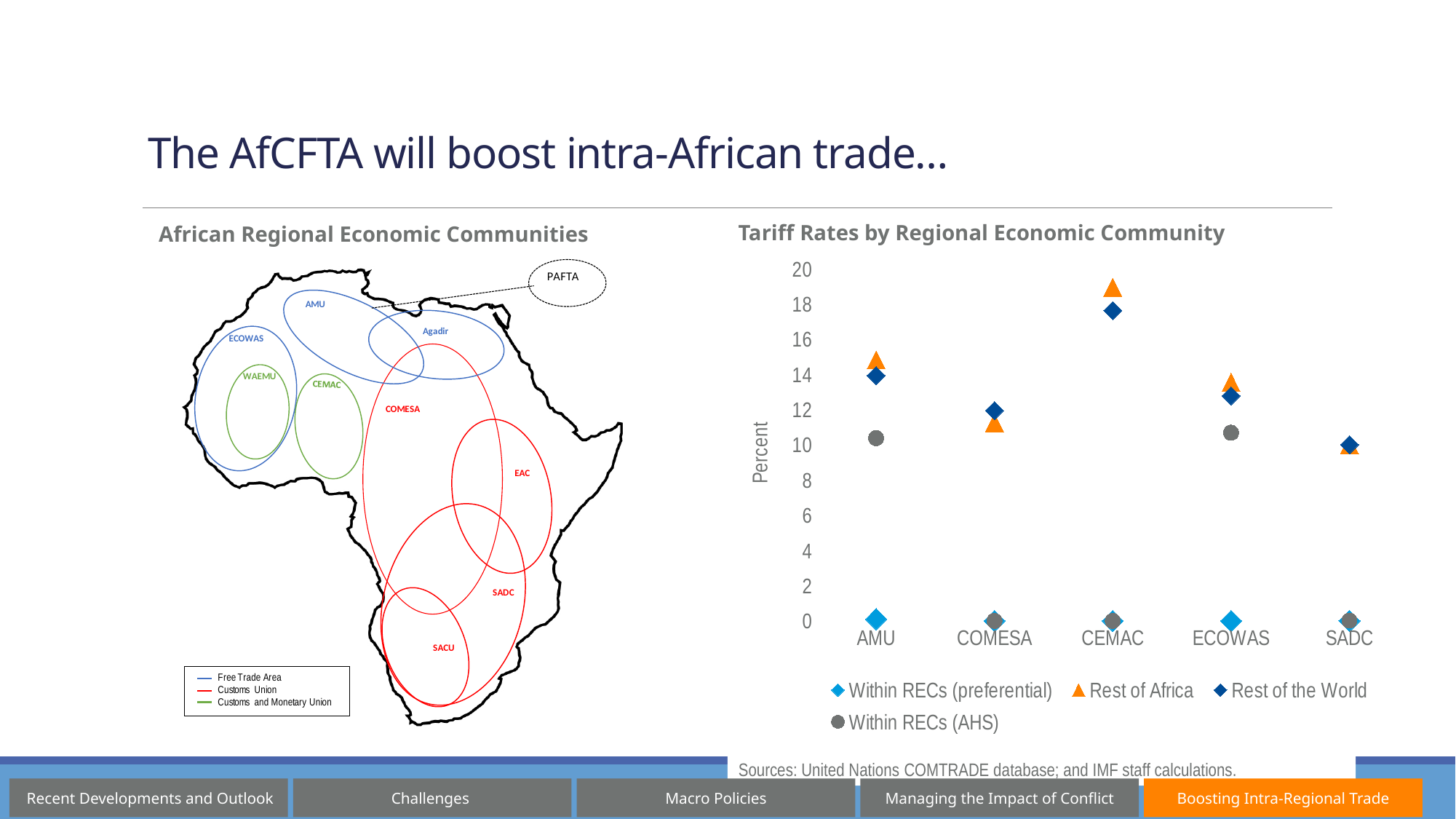
In the "Tariff Rates by Regional Economic Community" chart, which community has the lowest Rest of the World tariff rate? SADC How many regional economic communities are shown on the x axis of the "Tariff Rates by Regional Economic Community" chart? 5 How many series does the legend of the "Tariff Rates by Regional Economic Community" chart list? 4 In the "Tariff Rates by Regional Economic Community" chart, is the Within RECs (preferential) value for ECOWAS greater or less than 2? less What is the y-axis label of the "Tariff Rates by Regional Economic Community" chart? Percent In the "Tariff Rates by Regional Economic Community" chart, for CEMAC, which is larger: the Rest of Africa value or the Rest of the World value? Rest of Africa What kind of chart is "Tariff Rates by Regional Economic Community"? scatter chart In the "Tariff Rates by Regional Economic Community" chart, is the Rest of the World value for AMU greater or less than 16? less In the "Tariff Rates by Regional Economic Community" chart, is the Rest of Africa value for CEMAC greater or less than 18? greater In the "Tariff Rates by Regional Economic Community" chart, which community has the highest Rest of Africa tariff rate? CEMAC In the "Tariff Rates by Regional Economic Community" chart, which is larger: the Rest of the World value for AMU or the Rest of the World value for SADC? AMU